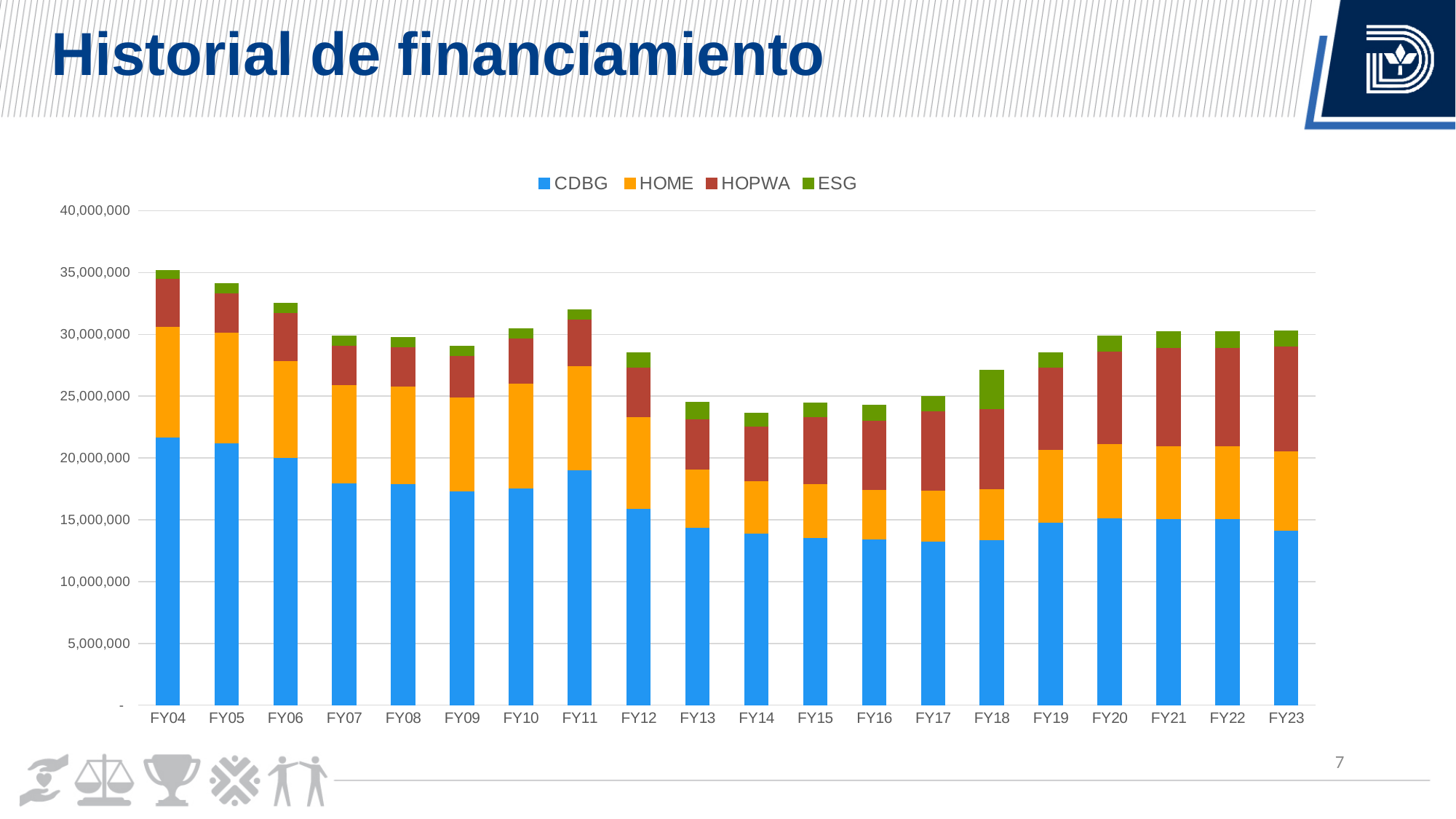
Which fiscal year has the highest total stacked bar? FY04 Do the total stacked values rise or fall from FY04 to FY07? fall Which has the larger CDBG value, FY05 or FY13? FY05 Is the CDBG value for FY23 greater or less than 15,000,000? less Which has the larger total stacked bar, FY11 or FY12? FY11 How many fiscal years are shown on the x axis? 20 What kind of chart is shown on the slide? Stacked bar chart Is the total stacked value for FY04 greater or less than 30,000,000? greater What is the title of the slide containing the chart? Historial de financiamiento How many series does the legend list? 4 Is the total stacked value for FY13 greater or less than 25,000,000? less